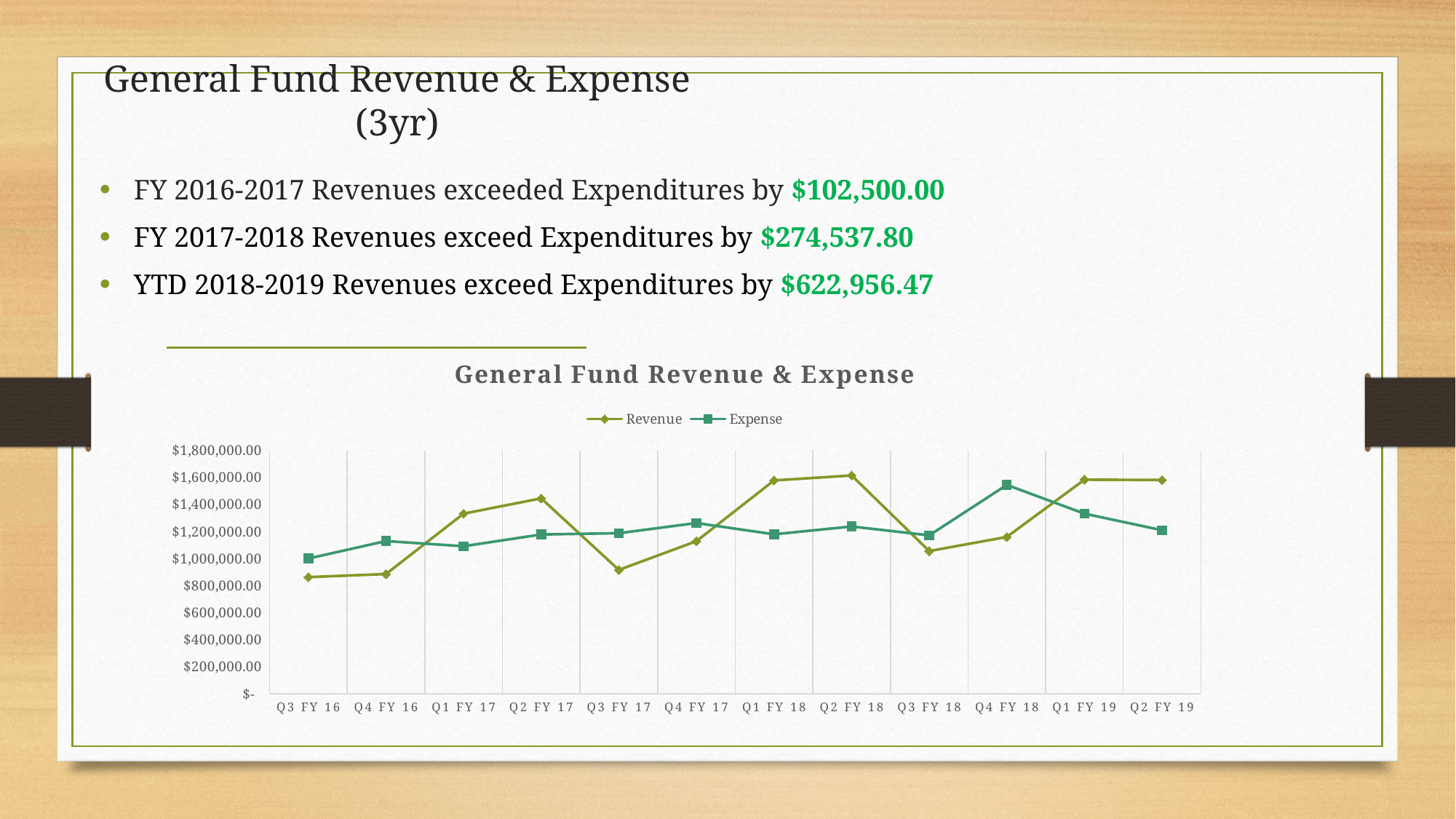
Is the Revenue value for Q3 FY 16 greater or less than $1,000,000.00? less What is the title of the chart? General Fund Revenue & Expense In Q3 FY 17, which is larger, Revenue or Expense? Expense What kind of chart is shown on the slide? Line chart How many quarters are plotted along the x axis of the chart? 12 Is the Revenue value for Q1 FY 18 greater or less than $1,400,000.00? greater How many series does the chart's legend list? 2 In which quarter is the Expense series at its lowest? Q3 FY 16 Is the Expense value for Q4 FY 18 greater or less than $1,400,000.00? greater In which quarter is the Expense series at its highest? Q4 FY 18 Does the Revenue series rise or fall from Q2 FY 18 to Q3 FY 18? Fall Which two series are listed in the chart's legend? Revenue and Expense